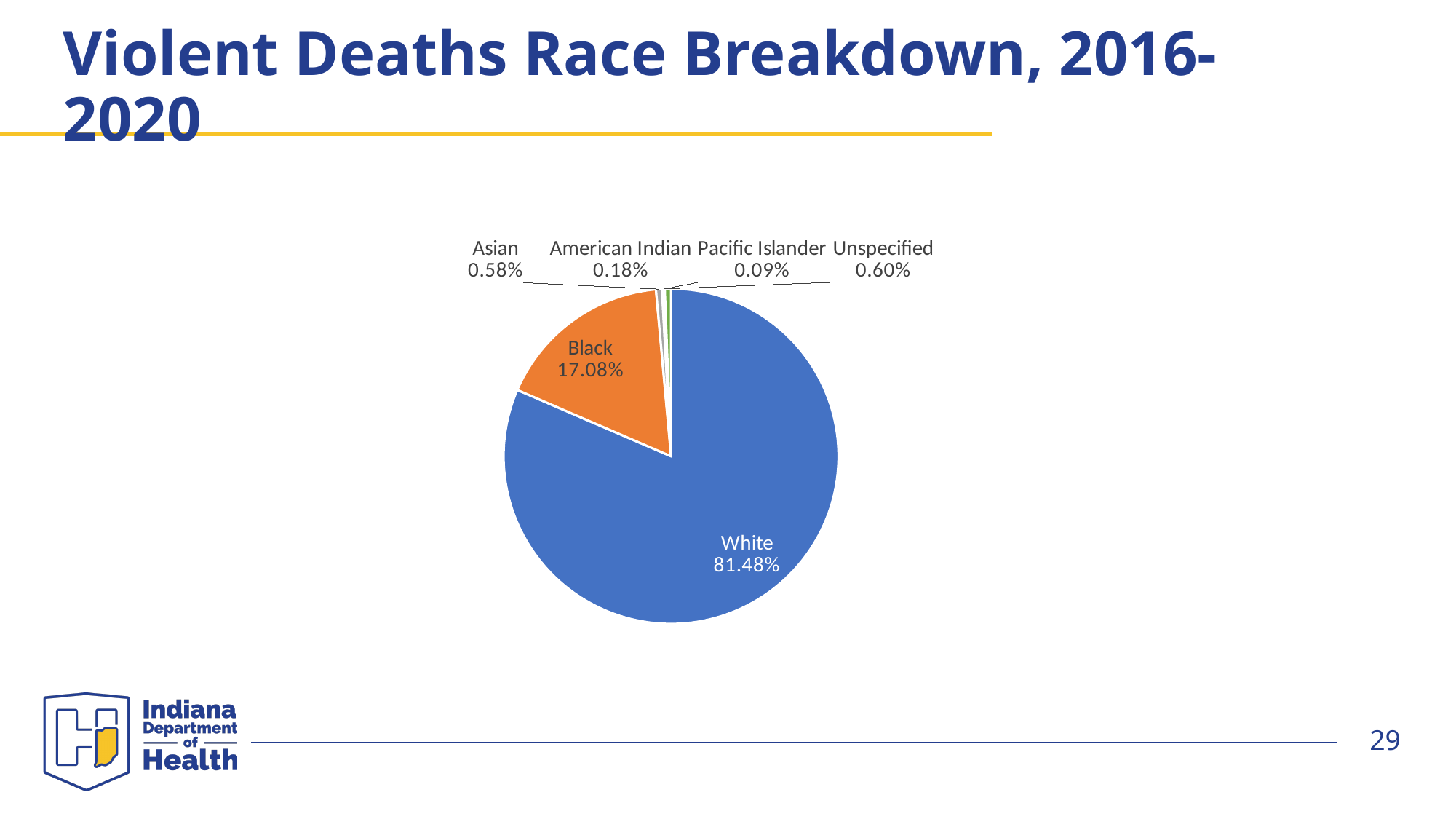
What percentage is shown for Pacific Islander? 0.09% What is the title of the chart on the slide? Violent Deaths Race Breakdown, 2016-2020 What kind of chart is shown on the slide? pie chart Which race category has the largest share of the pie? White What percentage is shown for Unspecified? 0.60% Which race category has the smallest share of the pie? Pacific Islander How many categories are shown in the pie chart? 6 What percentage is shown for Asian? 0.58% Which is larger, the share for Asian or the share for American Indian? Asian What percentage is shown for Black in the pie chart? 17.08% What share of violent deaths is attributed to White in the pie chart? 81.48% What is the difference in percentage points between the White and Black shares? 64.40%